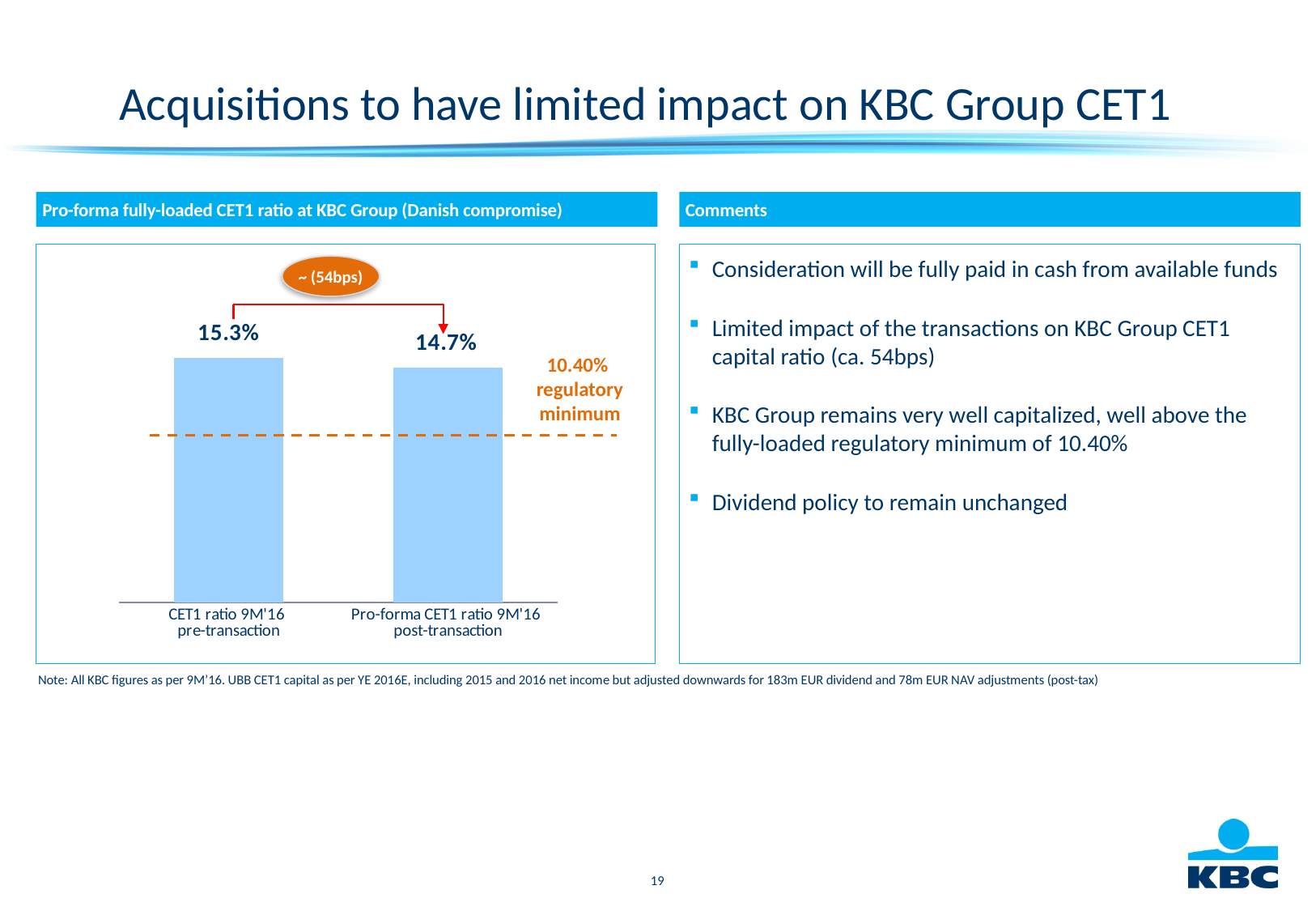
What impact in basis points is indicated by the arrow between the two bars? ~ (54bps) What regulatory minimum is marked by the dashed line in the chart? 10.40% What is the difference in percentage points between the pre-transaction and post-transaction CET1 ratios? 0.6 percentage points What is the CET1 ratio 9M'16 pre-transaction? 15.3% How many bars are shown in the chart? 2 What type of chart is shown on the slide? Bar chart What is the pro-forma CET1 ratio 9M'16 post-transaction? 14.7% Which category has the lowest value in the chart? Pro-forma CET1 ratio 9M'16 post-transaction What is the title of the chart panel? Pro-forma fully-loaded CET1 ratio at KBC Group (Danish compromise) Which bar is higher, CET1 ratio 9M'16 pre-transaction or pro-forma CET1 ratio 9M'16 post-transaction? CET1 ratio 9M'16 pre-transaction Do the values rise or fall from the pre-transaction bar to the post-transaction bar? Fall